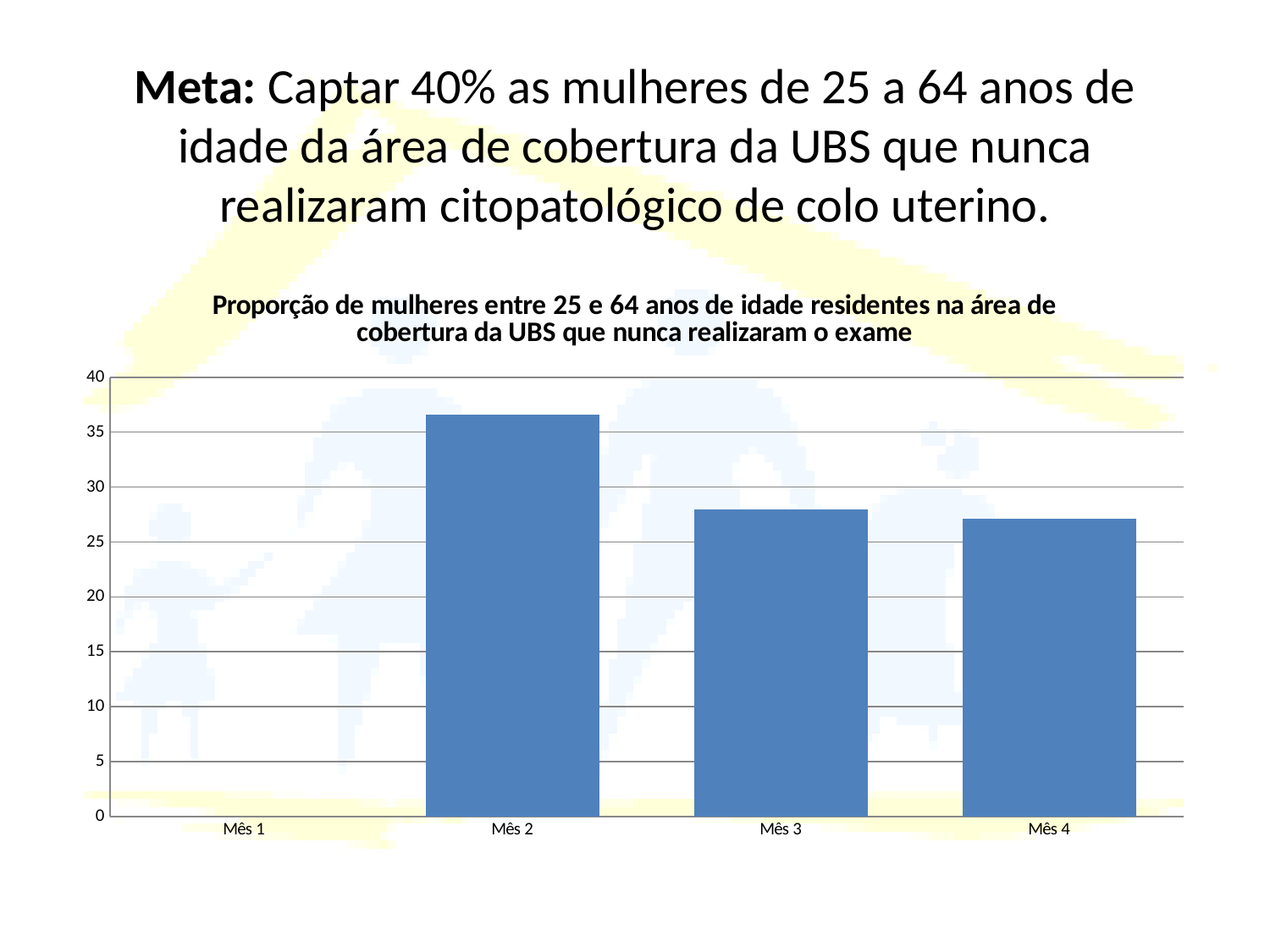
Is the value for Mês 3 greater or less than 25? greater Is the value for Mês 2 greater or less than 35? greater What is the title of the chart? Proporção de mulheres entre 25 e 64 anos de idade residentes na área de cobertura da UBS que nunca realizaram o exame Which month has the highest value in the chart? Mês 2 Which is larger, the value for Mês 2 or the value for Mês 4? Mês 2 Do the values rise or fall from Mês 2 to Mês 4? fall What kind of chart is shown on the slide? bar chart How many categories (months) are shown on the x axis of the chart? 4 Is the value for Mês 4 greater or less than 25? greater What is the highest value shown on the vertical axis of the chart? 40